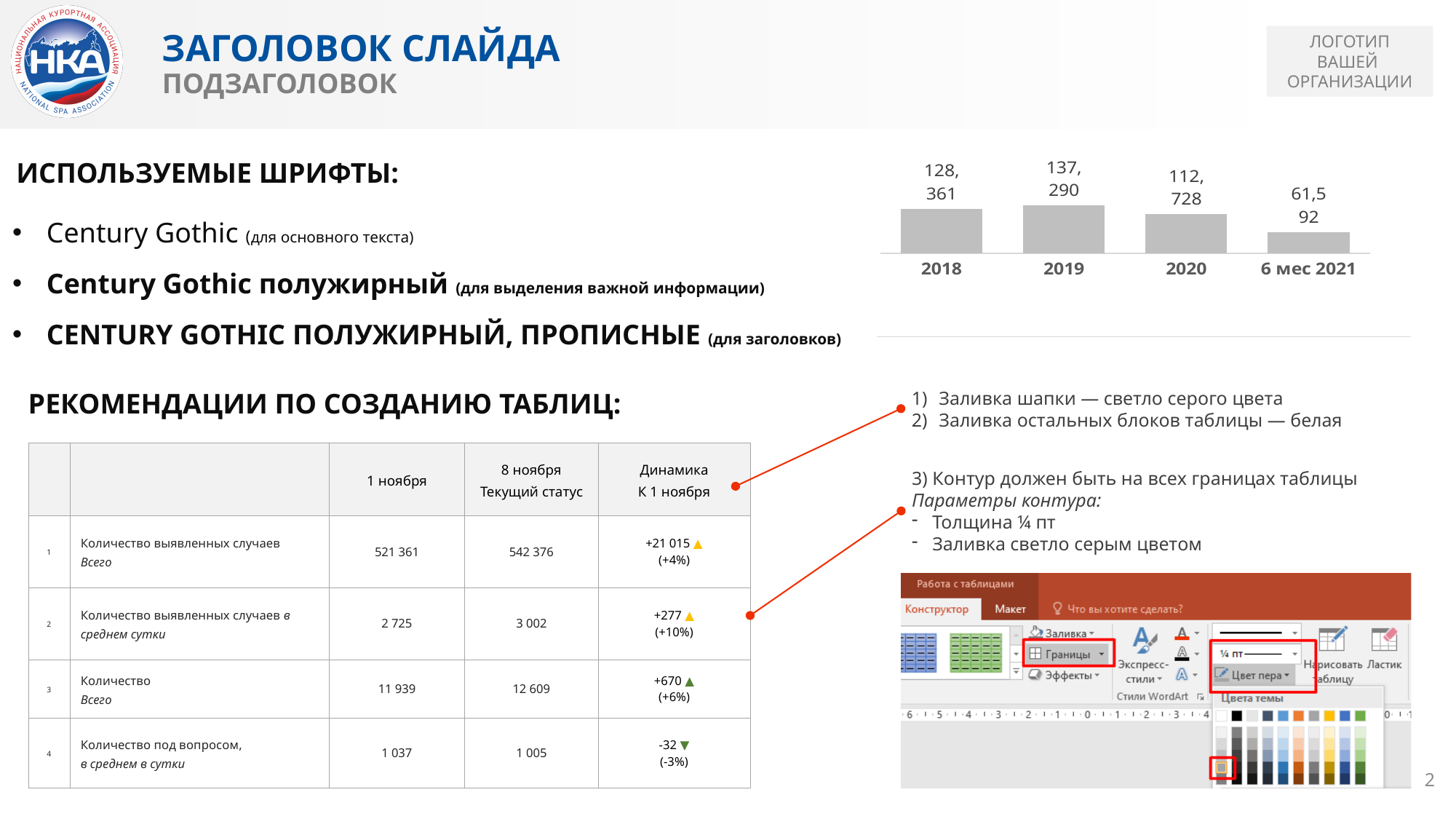
In the bar chart, what is the difference between the values for 2019 and 2018? 8,929 In the bar chart, what is the value for 2019? 137,290 What type of chart is shown in the top right of the slide? bar chart How many categories are shown on the x axis of the bar chart? 4 In the bar chart, do the values rise or fall from 2019 to 6 мес 2021? fall In the bar chart, what is the value for 2020? 112,728 In the bar chart, which is larger: the value for 2018 or the value for 2020? 2018 In the bar chart, which category has the lowest value? 6 мес 2021 In the bar chart, what is the value for 6 мес 2021? 61,592 In the bar chart, what is the value for 2018? 128,361 In the bar chart, what is the difference between the values for 2020 and 6 мес 2021? 51,136 In the bar chart, which category has the highest value? 2019